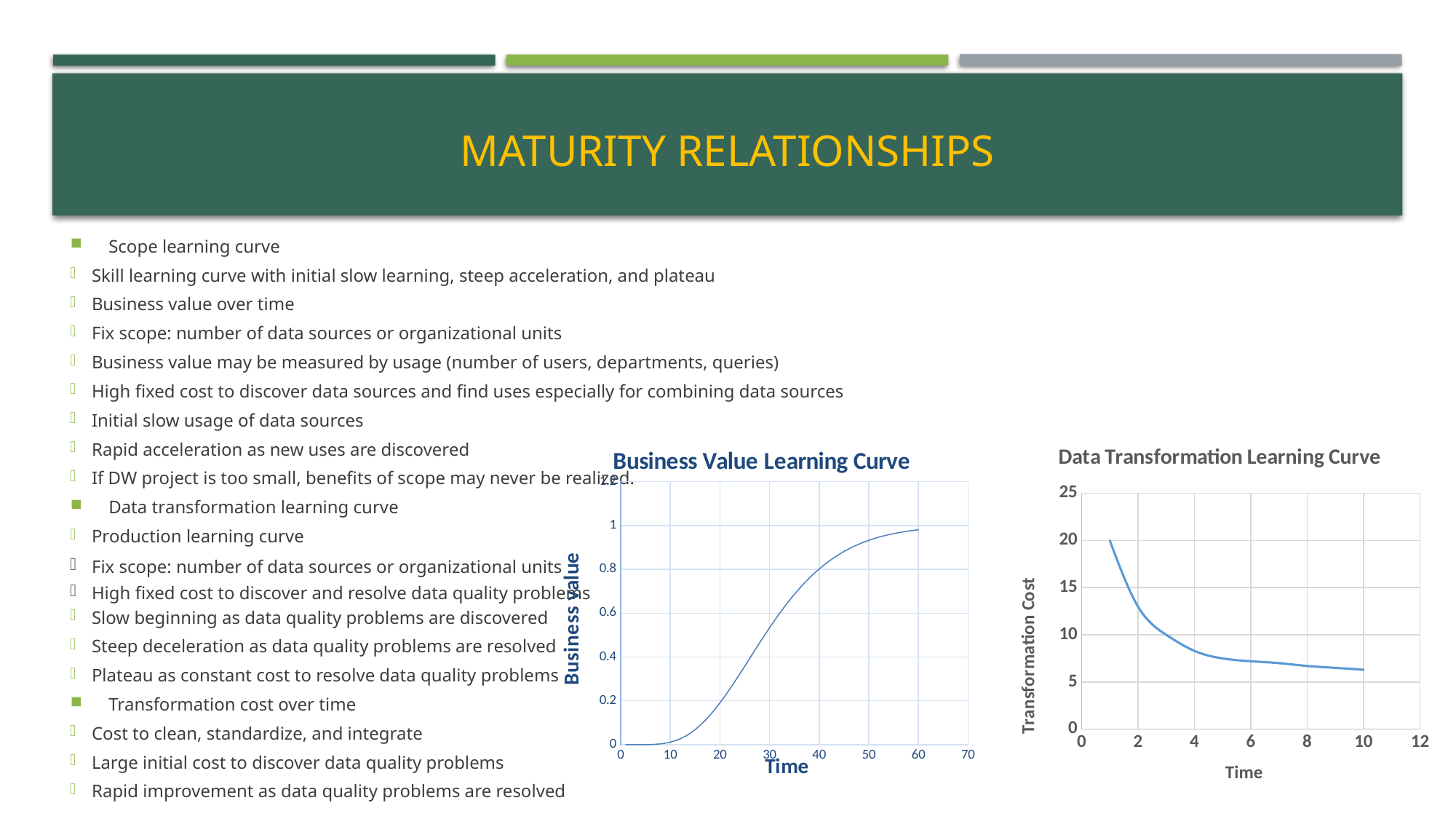
In the Business Value Learning Curve chart, do the values rise or fall as time increases? rise In the Data Transformation Learning Curve chart, is the transformation cost at time 10 greater or less than 10? less In the Data Transformation Learning Curve chart, is the transformation cost at time 2 greater or less than 10? greater In the Business Value Learning Curve chart, is the business value at time 10 greater or less than 0.2? less What kind of chart is the Data Transformation Learning Curve? line chart In the Data Transformation Learning Curve chart, do the values rise or fall as time increases? fall What kind of chart is the Business Value Learning Curve? line chart What is the label of the horizontal axis in the Business Value Learning Curve chart? Time What is the label of the vertical axis in the Data Transformation Learning Curve chart? Transformation Cost